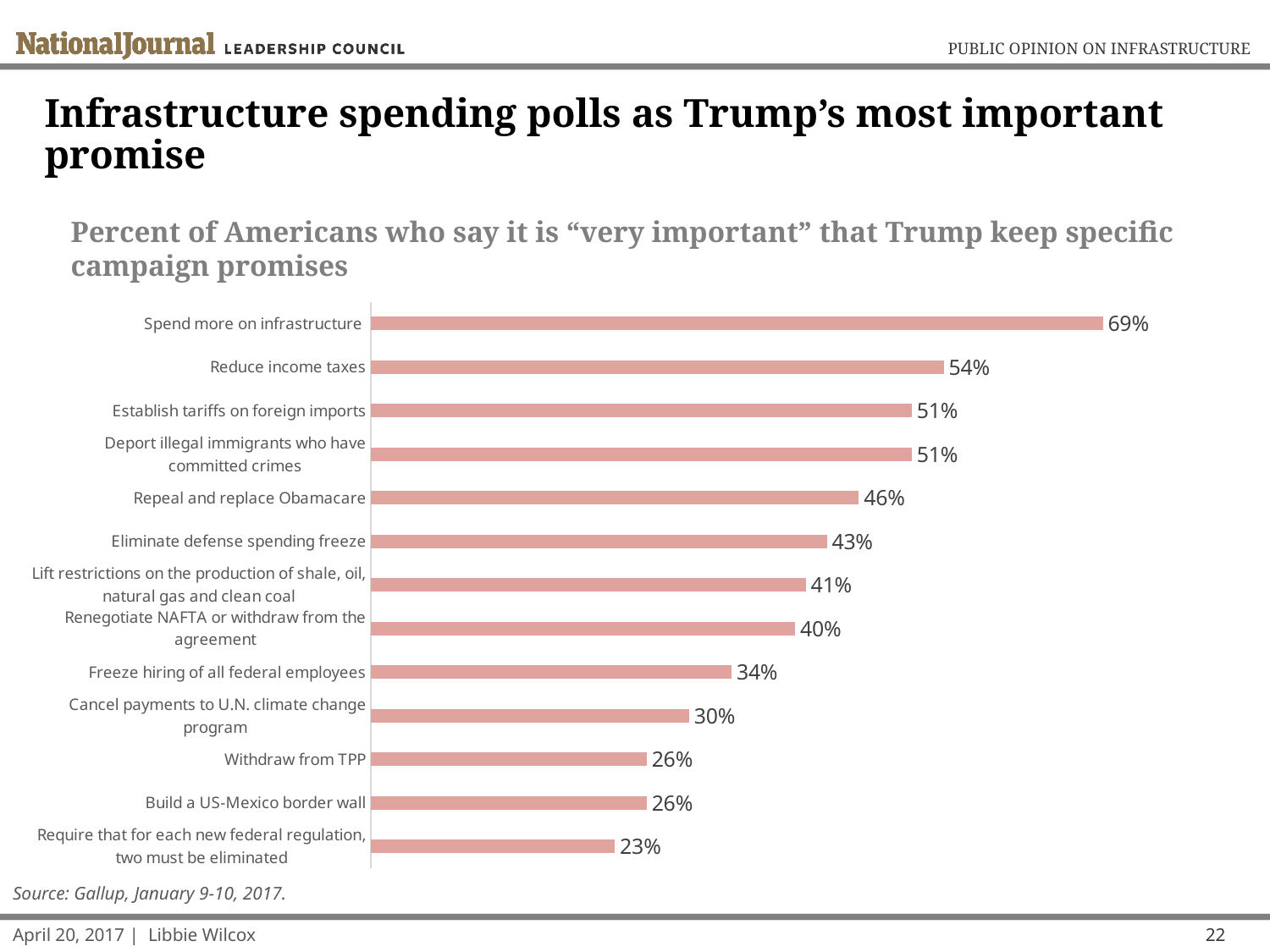
What is the value for "Freeze hiring of all federal employees"? 34% What is the value for "Repeal and replace Obamacare"? 46% What is the value for "Build a US-Mexico border wall"? 26% What is the source cited for the chart data? Gallup, January 9-10, 2017 What is the difference between the values for "Spend more on infrastructure" and "Reduce income taxes"? 15% How many campaign promises are shown in the chart? 13 What kind of chart is shown on the slide? Bar chart What is the difference between the values for "Eliminate defense spending freeze" and "Withdraw from TPP"? 17% Which is larger, the value for "Reduce income taxes" or the value for "Repeal and replace Obamacare"? Reduce income taxes Which campaign promise has the lowest percentage? Require that for each new federal regulation, two must be eliminated Which campaign promise has the highest percentage? Spend more on infrastructure What percent of Americans say it is very important that Trump spend more on infrastructure? 69%